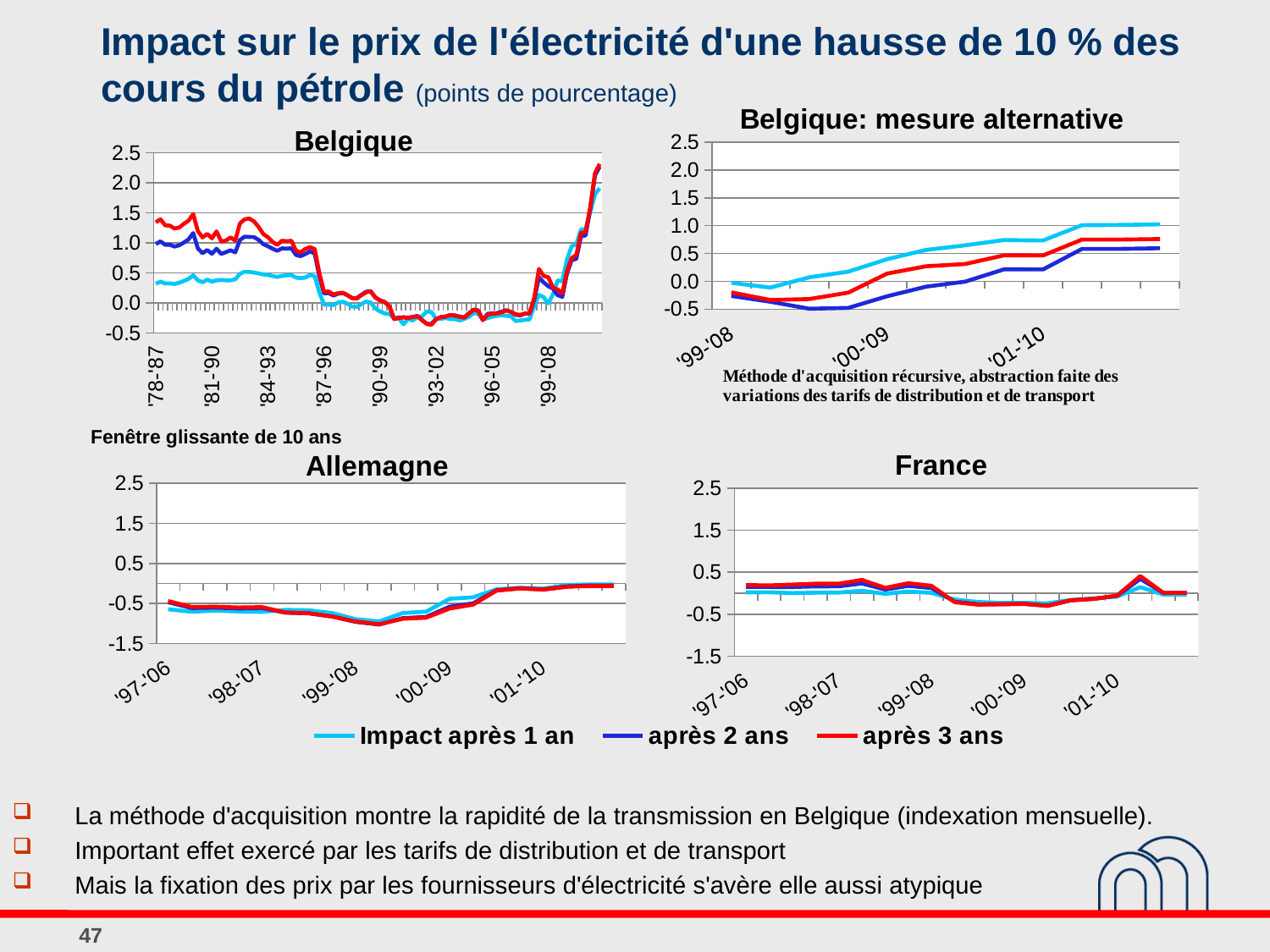
In the 'Belgique' chart, is the highest value of the 'après 3 ans' series greater or less than 2.0? greater How many series does the shared legend list? 3 In the 'Belgique: mesure alternative' chart, do the values rise or fall along the x axis? rise In the 'Belgique: mesure alternative' chart, is the value for 'Impact après 1 an' at '01-'10 greater or less than 0.5? greater What is the title of the chart in the top right of the slide? Belgique: mesure alternative What are the three series named in the legend? Impact après 1 an, après 2 ans, après 3 ans In the 'Belgique' chart, is the value for 'Impact après 1 an' at '78-'87 greater or less than 0.5? less How many charts are shown on the slide? 4 What kind of chart is the 'Belgique' chart? line chart In the 'Belgique' chart, which series has the highest value at '78-'87? après 3 ans In the 'Belgique: mesure alternative' chart, at '01-'10, which is larger: 'Impact après 1 an' or 'après 2 ans'? Impact après 1 an